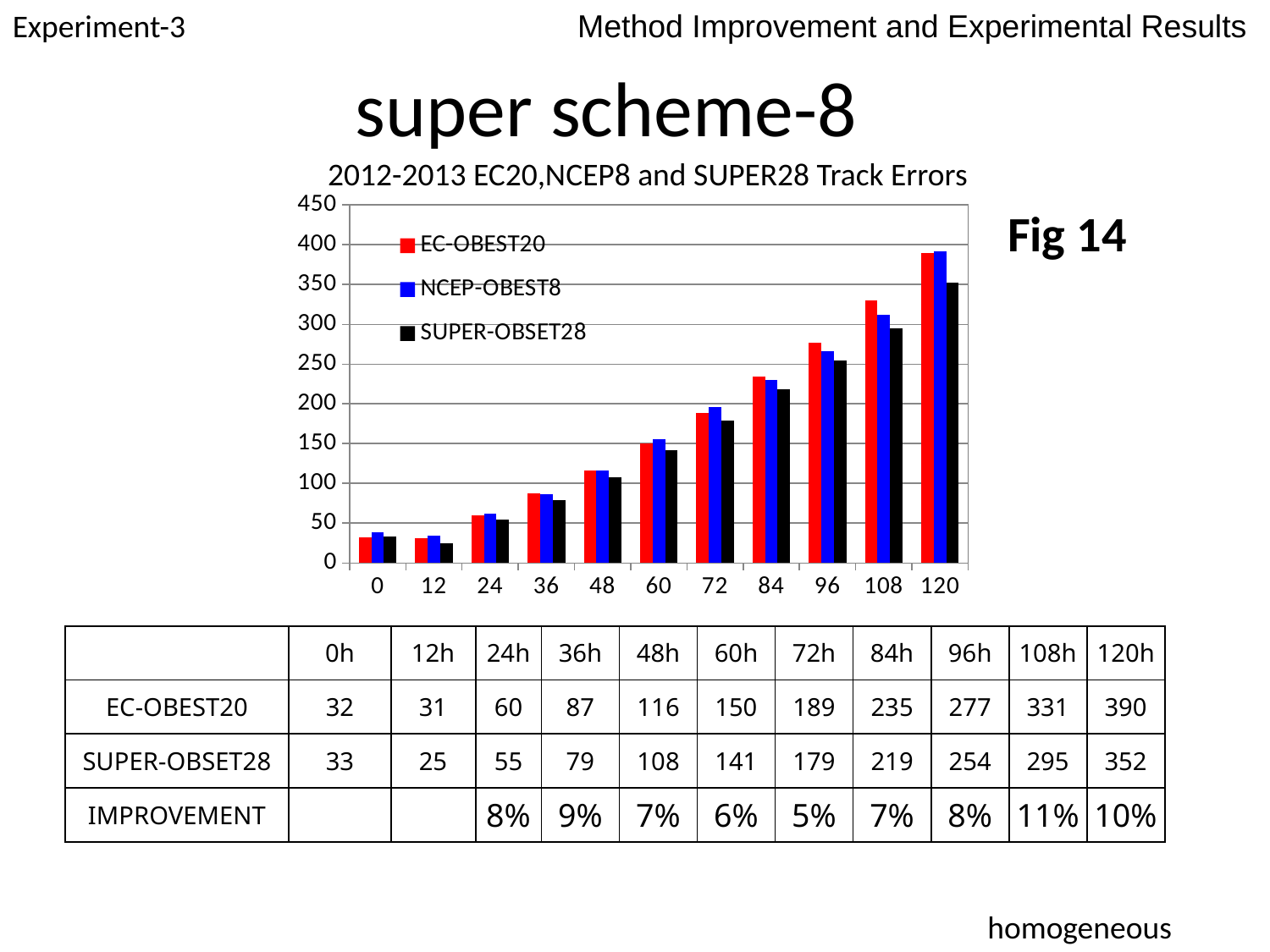
Is the NCEP-OBEST8 value at 120 greater or less than 350? greater What kind of chart is shown in Fig 14? bar chart At 120h, which is larger: the EC-OBEST20 or the SUPER-OBSET28 track error? EC-OBEST20 At which forecast hour is the EC-OBEST20 track error highest? 120 What is the EC-OBEST20 track error at 120h? 390 What is the difference between the EC-OBEST20 and SUPER-OBSET28 track errors at 108h? 36 How many series does the legend of the chart list? 3 Do the track errors rise or fall as the forecast hour increases along the x axis? rise How many forecast-hour categories are plotted along the x axis of the chart? 11 At which forecast hour is the SUPER-OBSET28 track error lowest? 12 What is the title of the chart? 2012-2013 EC20,NCEP8 and SUPER28 Track Errors What is the SUPER-OBSET28 track error at 96h? 254